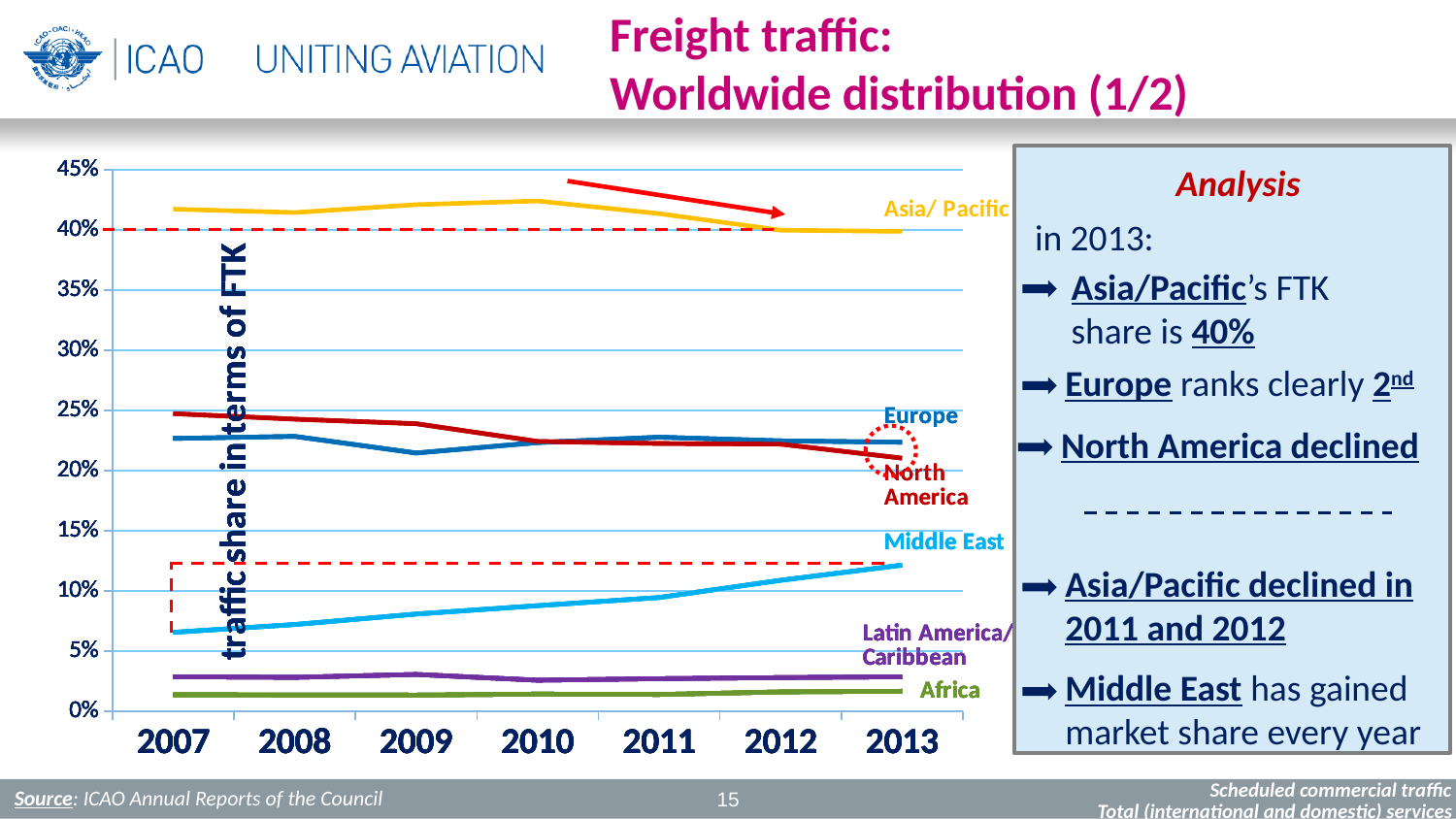
Which region has the highest traffic share in 2013? Asia/Pacific What is the label on the y axis of the chart? traffic share in terms of FTK Does the Middle East's traffic share rise or fall from 2007 to 2013? rise Which region has the lowest traffic share in 2013? Africa In 2007, which has the larger traffic share, North America or Europe? North America Is the value for Middle East in 2013 greater or less than 10%? greater How many years are shown on the x axis of the chart? 7 In 2013, which has the larger traffic share, Europe or North America? Europe What is Asia/Pacific's FTK share in 2013? 40% How many regions (series) are plotted on the chart? 6 Is the value for Asia/Pacific in 2007 greater or less than 40%? greater What kind of chart is shown on the slide? line chart